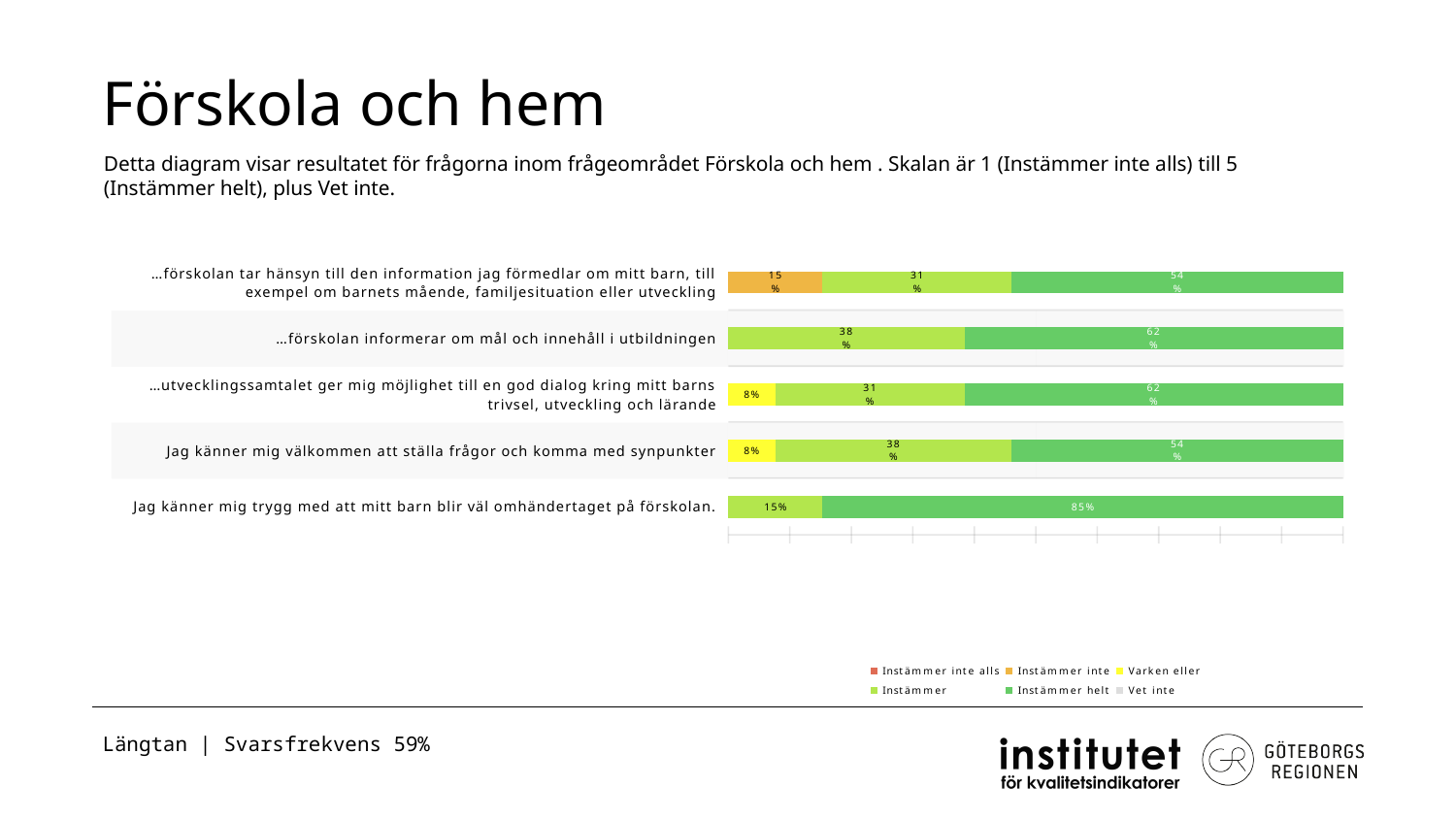
What is the 'Instämmer' value for '…förskolan informerar om mål och innehåll i utbildningen'? 38% How many series does the legend list? 6 What is the difference between the 'Instämmer helt' values for '…förskolan informerar om mål och innehåll i utbildningen' and 'Jag känner mig välkommen att ställa frågor och komma med synpunkter'? 8% How many statements (categories) are plotted in the chart? 5 Which statement has the lowest 'Instämmer' value? Jag känner mig trygg med att mitt barn blir väl omhändertaget på förskolan What is the 'Instämmer helt' value for 'Jag känner mig trygg med att mitt barn blir väl omhändertaget på förskolan'? 85% What is the 'Instämmer inte' value for '…förskolan tar hänsyn till den information jag förmedlar om mitt barn, till exempel om barnets mående, familjesituation eller utveckling'? 15% What is the total of the labelled segments for '…utvecklingssamtalet ger mig möjlighet till en god dialog kring mitt barns trivsel, utveckling och lärande'? 101% Which statement has the highest 'Instämmer helt' value? Jag känner mig trygg med att mitt barn blir väl omhändertaget på förskolan What is the 'Varken eller' value for 'Jag känner mig välkommen att ställa frågor och komma med synpunkter'? 8% What kind of chart is shown on the slide? Stacked bar chart Which is larger: the 'Instämmer' value for '…förskolan tar hänsyn till den information jag förmedlar om mitt barn…' or the 'Instämmer' value for 'Jag känner mig välkommen att ställa frågor och komma med synpunkter'? Jag känner mig välkommen att ställa frågor och komma med synpunkter